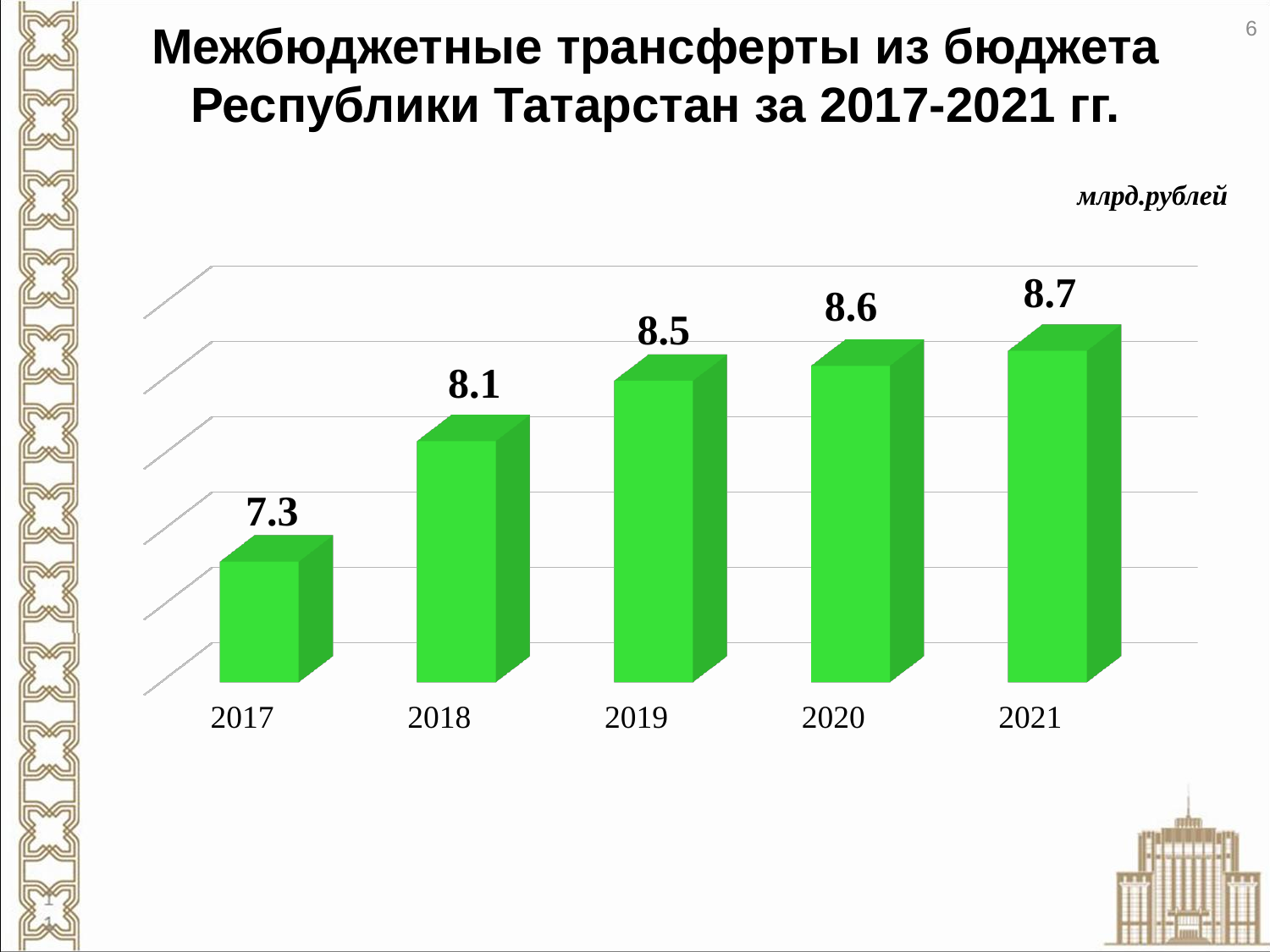
What is the difference between the values for 2019 and 2018? 0.4 What is the difference between the values for 2021 and 2017? 1.4 What is the value for 2019? 8.5 What unit is stated for the values on the chart? млрд.рублей What is the value for 2021? 8.7 Which is larger, the value for 2018 or the value for 2020? 2020 What kind of chart is this? bar chart Which year has the lowest value? 2017 Do the values rise or fall from 2017 to 2021? rise How many years are shown on the chart? 5 Which year has the highest value? 2021 What is the value for 2017? 7.3